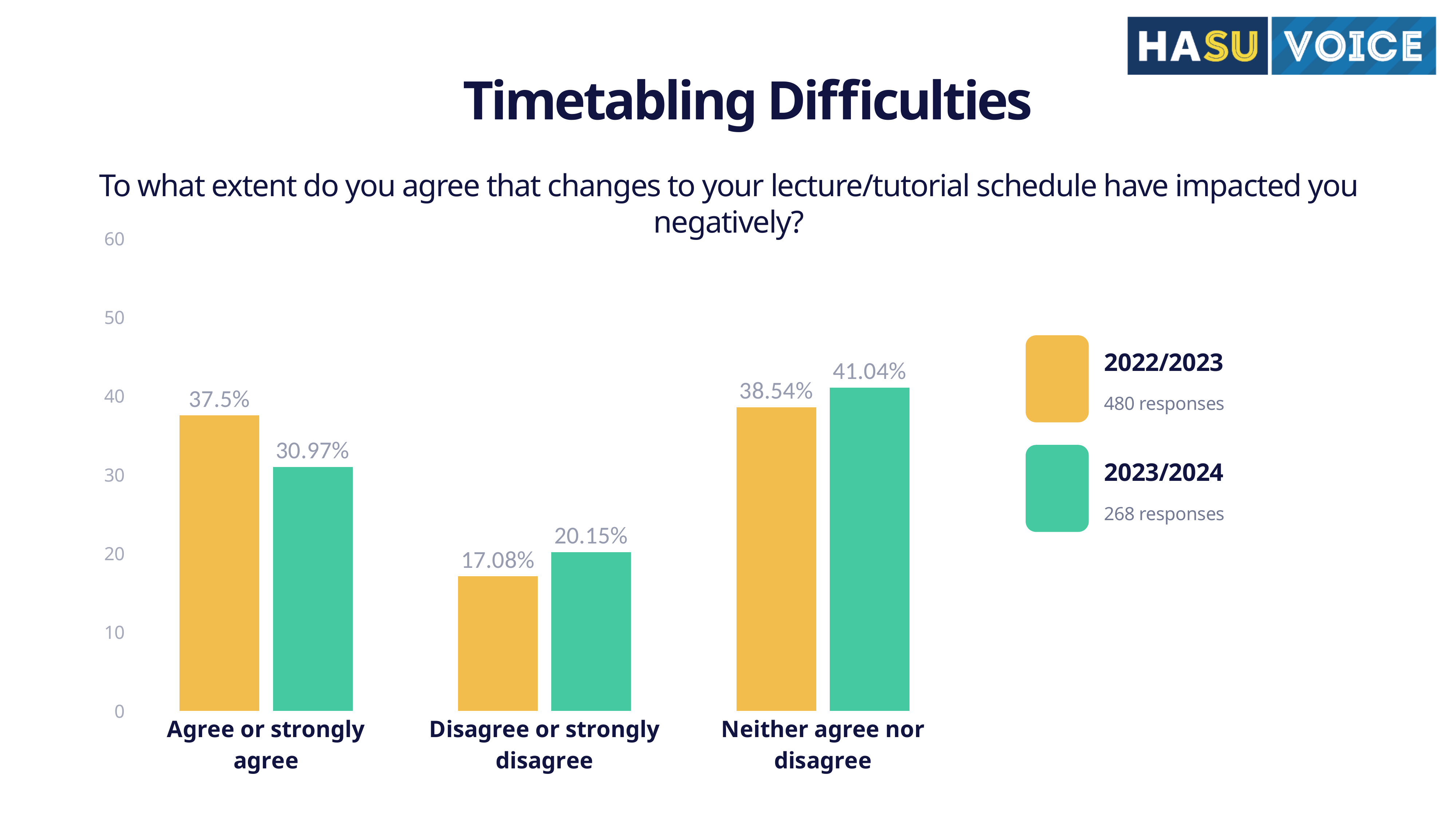
Which category has the lowest value in the 2022/2023 series? Disagree or strongly disagree What is the value for 'Agree or strongly agree' in the 2022/2023 series? 37.5% How many responses does the legend give for the 2023/2024 series? 268 responses How many categories are shown on the x axis? 3 What kind of chart is shown on the slide? Bar chart For 'Disagree or strongly disagree', which series has the larger value, 2022/2023 or 2023/2024? 2023/2024 What is the value for 'Neither agree nor disagree' in the 2023/2024 series? 41.04% What is the difference between the 2022/2023 and 2023/2024 values for 'Agree or strongly agree'? 6.53% Which category has the highest value in the 2023/2024 series? Neither agree nor disagree How many series does the legend list? 2 Is the 2022/2023 value for 'Neither agree nor disagree' greater or less than 30? greater What is the value for 'Disagree or strongly disagree' in the 2022/2023 series? 17.08%